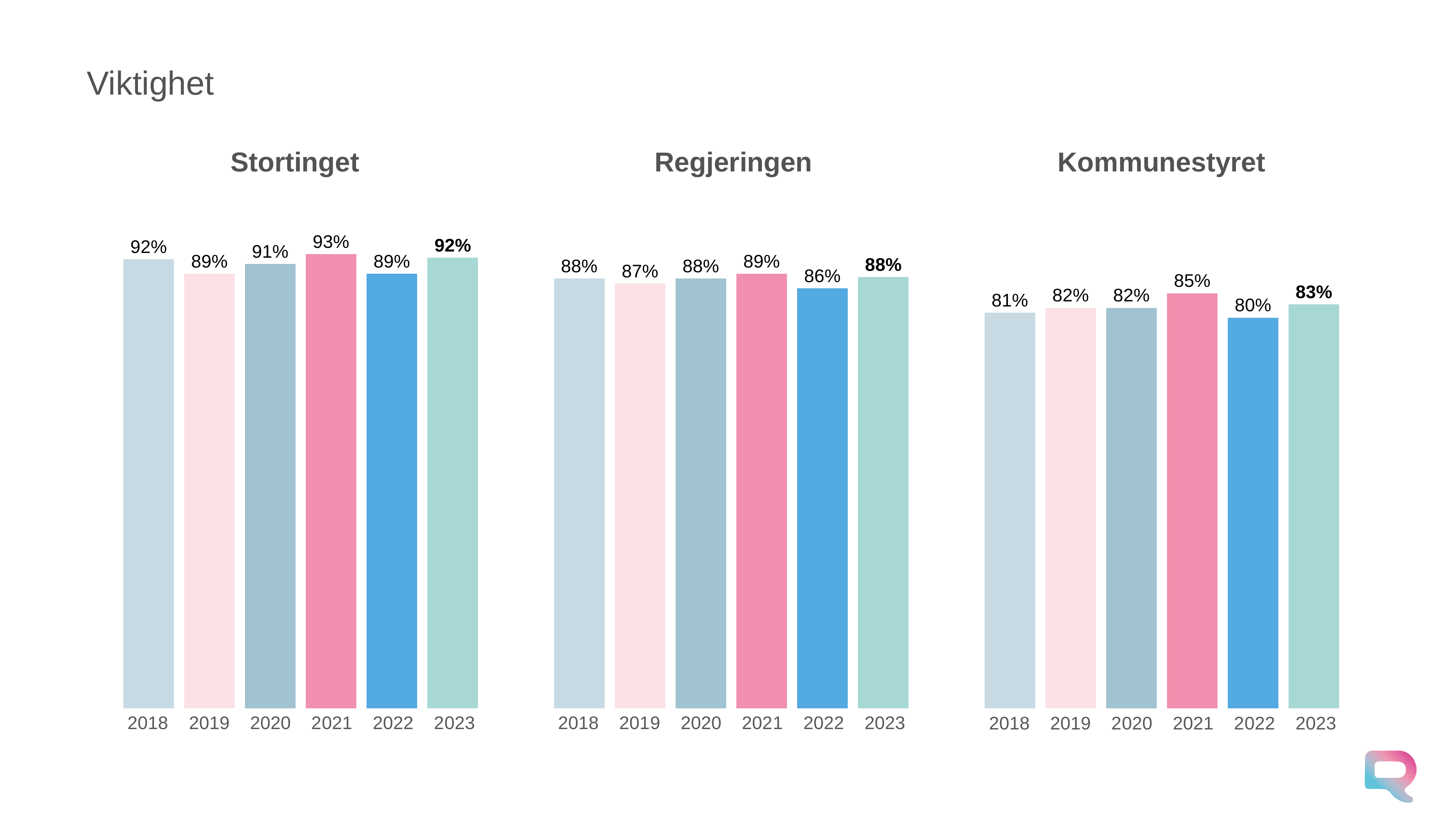
In the Regjeringen chart, what is the difference between the 2021 value and the 2022 value? 3% In the Kommunestyret chart, what is the difference between the 2021 value and the 2018 value? 4% In the Regjeringen chart, what is the value for 2022? 86% In the Kommunestyret chart, which year has the lowest value? 2022 In the Stortinget chart, what is the value for 2021? 93% In the Kommunestyret chart, which year has the highest value? 2021 In the Stortinget chart, which year has the highest value? 2021 What is the title of the chart on the right of the slide? Kommunestyret How many years are shown in the Regjeringen chart? 6 What kind of chart is the Stortinget chart? bar chart In the Stortinget chart, which is larger, the value for 2020 or the value for 2019? 2020 In the Kommunestyret chart, what is the value for 2023? 83%